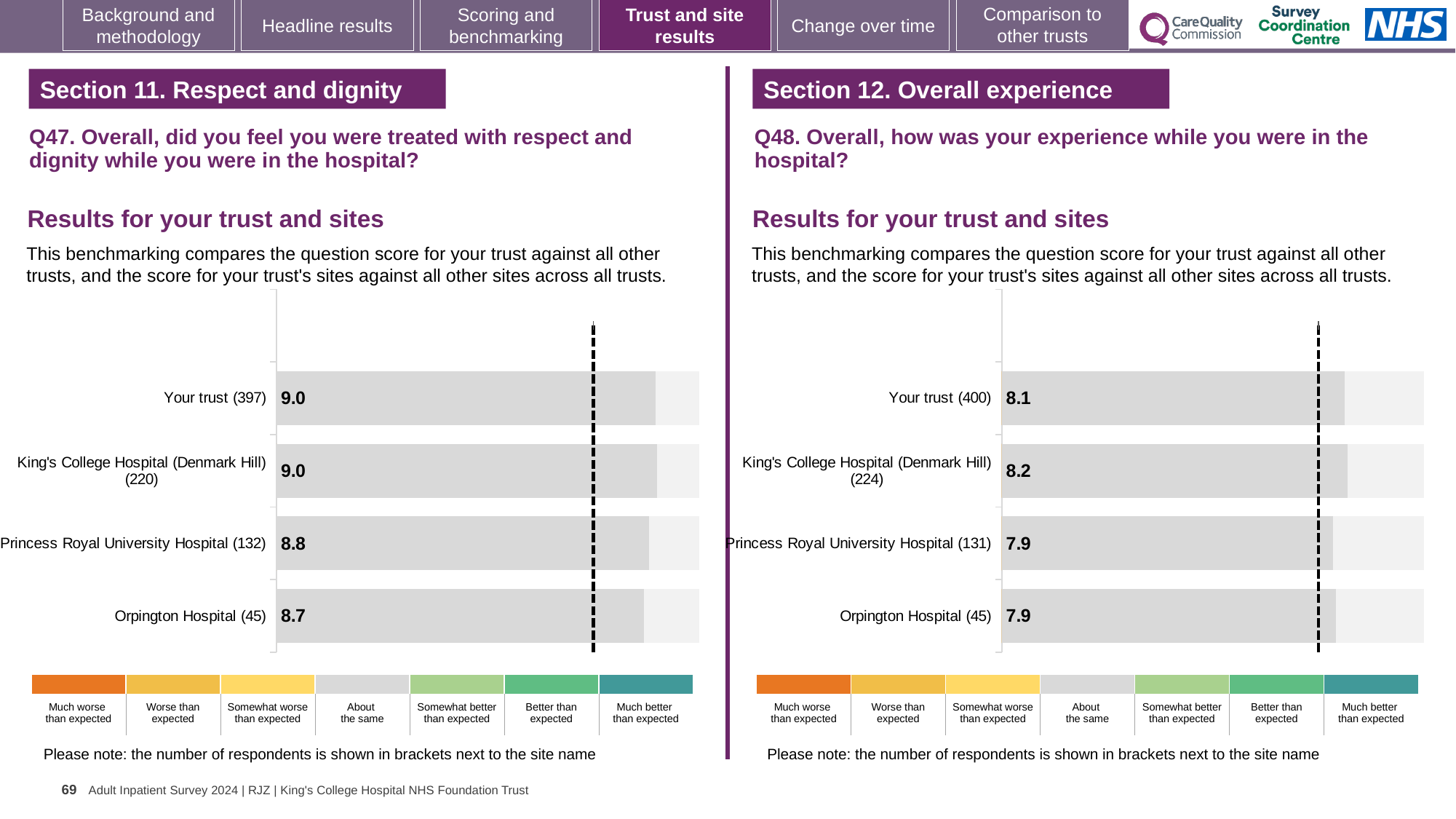
On the Q47 chart (left), what is the score for Orpington Hospital? 8.7 On the Q47 chart (left), what is the difference between the score for Your trust and the score for Orpington Hospital? 0.3 On the Q47 chart (left), is the score for Princess Royal University Hospital larger or smaller than the score for Your trust? smaller On the Q47 chart (left), what is the score for Your trust? 9.0 On the Q48 chart (right), what is the score for Princess Royal University Hospital? 7.9 On the Q48 chart (right), which bar has the highest score? King's College Hospital (Denmark Hill) On the Q48 chart (right), what is the difference between the score for King's College Hospital (Denmark Hill) and the score for Orpington Hospital? 0.3 On the Q47 chart (left), which site has the lowest score? Orpington Hospital What type of chart is used for the Q47 results (left)? bar chart On the Q48 chart (right), what is the score for King's College Hospital (Denmark Hill)? 8.2 On the Q48 chart (right), how many respondents are shown in brackets for Your trust? 400 How many bars are plotted on the Q48 chart (right)? 4